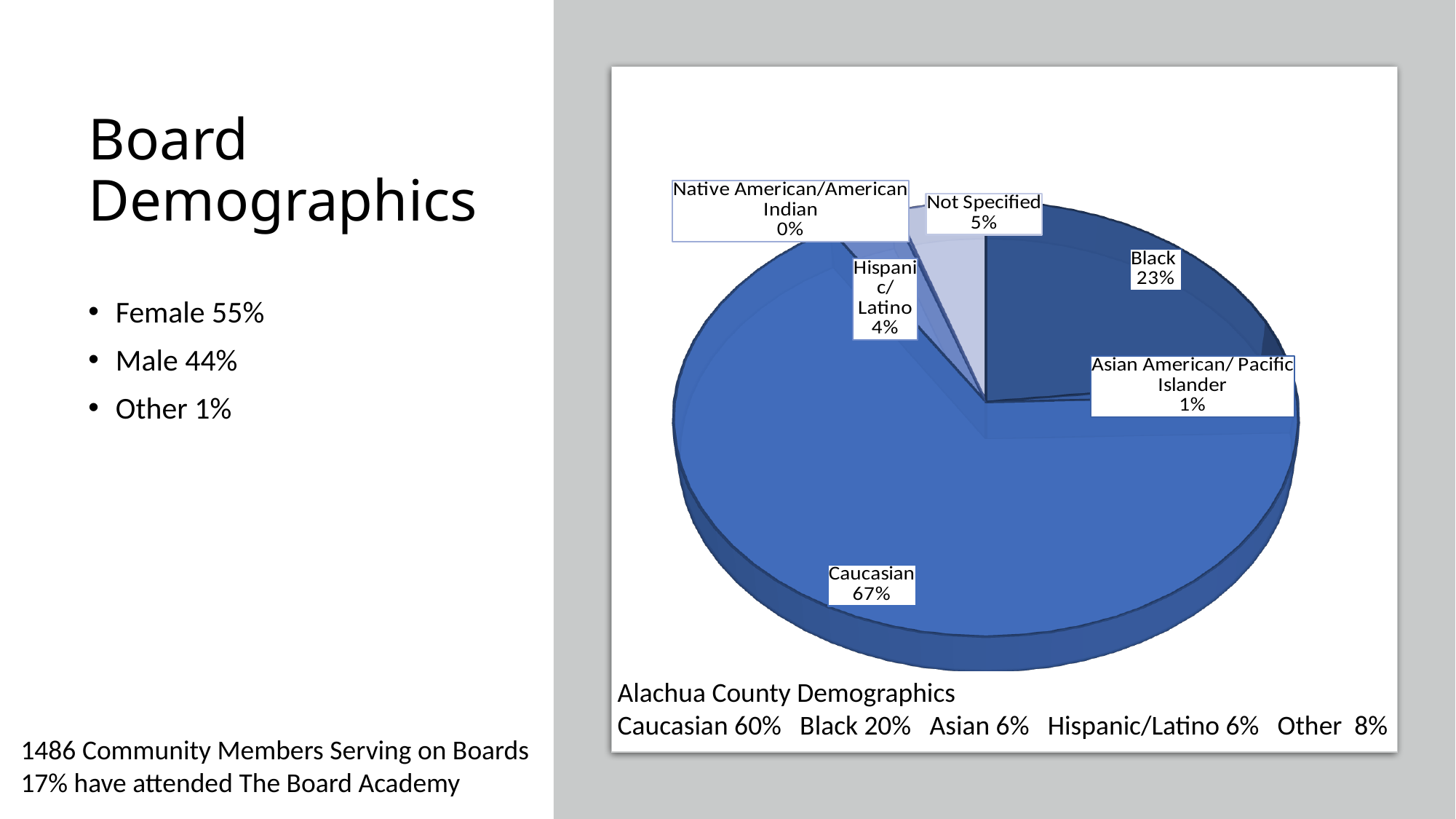
How many categories are shown in the pie chart? 6 Which category has the largest slice of the pie chart? Caucasian What percentage of the pie chart is Black? 23% What percentage of the pie chart is Not Specified? 5% Which slice is larger, Not Specified or Hispanic/Latino? Not Specified Which category has the smallest slice of the pie chart? Native American/American Indian What percentage of the pie chart is Hispanic/Latino? 4% What kind of chart is shown on the slide? pie chart What percentage of the pie chart is Caucasian? 67% What percentage of the pie chart is Native American/American Indian? 0% What percentage of the pie chart is Asian American/Pacific Islander? 1% What is the difference in percentage points between the Caucasian and Black slices? 44